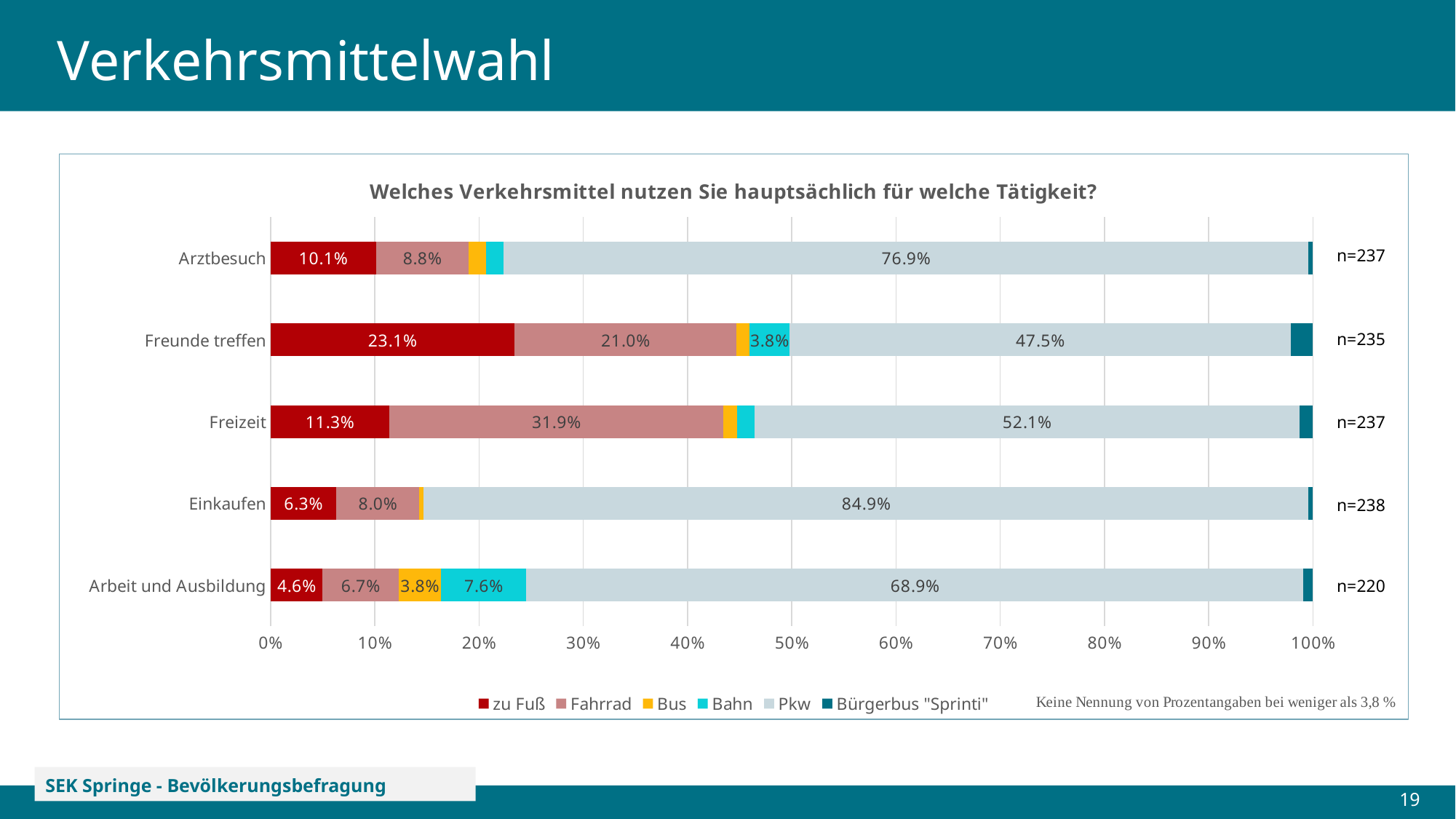
What is the zu Fuß share for Freunde treffen? 23.1% How many series does the legend list? 6 What is the Bahn share for Arbeit und Ausbildung? 7.6% Which is larger: the Fahrrad share for Freizeit or the Fahrrad share for Freunde treffen? Freizeit What is the difference between the Pkw share for Arztbesuch and the Pkw share for Freunde treffen? 29.4% Which activity has the lowest zu Fuß share? Arbeit und Ausbildung Which activity has the highest Pkw share? Einkaufen What type of chart is shown on the slide? Stacked bar chart How many activities (categories) are shown in the chart? 5 What is the Fahrrad share for Freizeit? 31.9% What is the Pkw share for Einkaufen? 84.9% What is the sample size (n) shown for Arbeit und Ausbildung? n=220